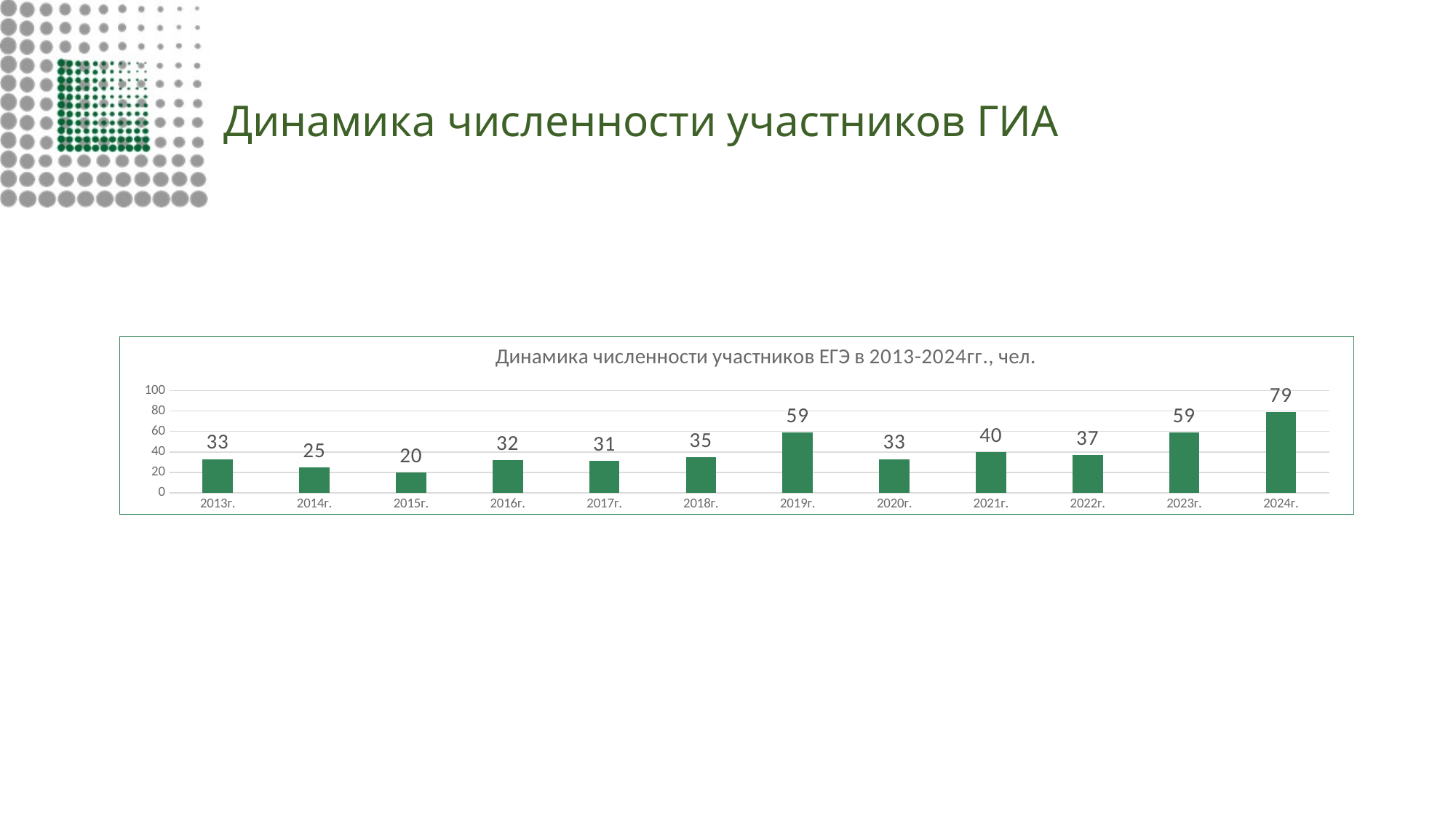
What is the value for 2015г.? 20 Which year has the lowest value? 2015г. Is the value for 2024г. greater or less than 60? greater Which is larger, the value for 2021г. or the value for 2018г.? 2021г. What is the value for 2019г.? 59 What kind of chart is shown on the slide? bar chart What is the difference between the values for 2019г. and 2020г.? 26 How many years are shown on the x axis? 12 What is the title of the chart? Динамика численности участников ЕГЭ в 2013-2024гг., чел. Which year has the highest value? 2024г. What is the value for 2022г.? 37 What is the difference between the values for 2024г. and 2023г.? 20